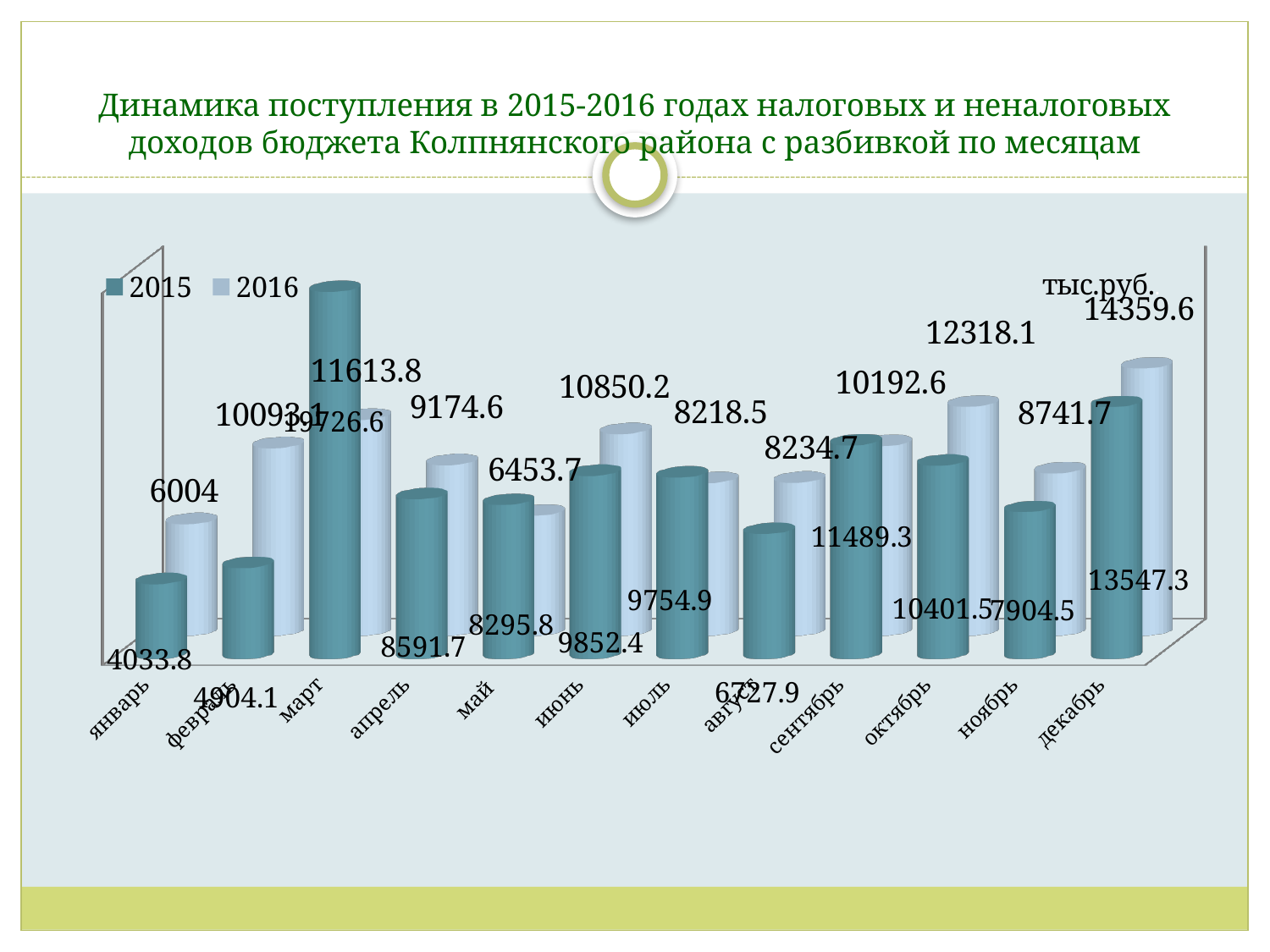
What is the value for декабрь in the 2016 series? 14359.6 How many months are shown on the x axis? 12 Which month has the highest value in the 2016 series? декабрь Which month has the lowest value in the 2015 series? январь Which month has the lowest value in the 2016 series? январь How many series does the legend list? 2 What is the value for март in the 2015 series? 19726.6 What unit is indicated for the values on the chart? тыс.руб. What is the value for октябрь in the 2016 series? 12318.1 What is the difference between the 2016 and 2015 values for декабрь? 812.3 For октябрь, which series has the larger value, 2015 or 2016? 2016 What kind of chart is shown on the slide? bar chart